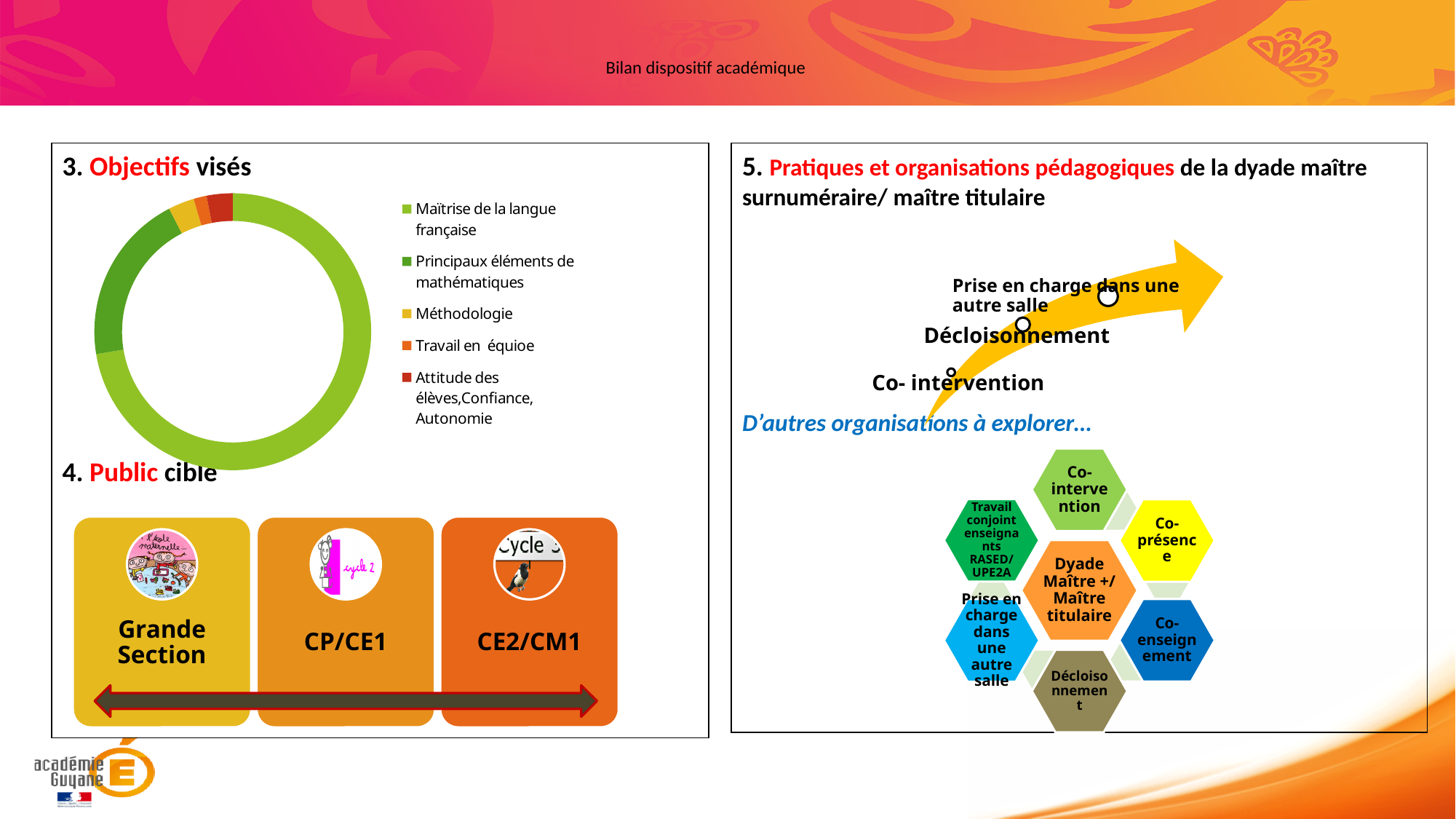
In the doughnut chart under "3. Objectifs visés", which is larger: Maîtrise de la langue française or Principaux éléments de mathématiques? Maîtrise de la langue française Which category takes up the largest share of the doughnut chart under "3. Objectifs visés"? Maîtrise de la langue française In the doughnut chart under "3. Objectifs visés", which is larger: Principaux éléments de mathématiques or Méthodologie? Principaux éléments de mathématiques What kind of chart is shown under "3. Objectifs visés"? Doughnut chart What colour represents Méthodologie in the doughnut chart under "3. Objectifs visés"? Yellow What is the last legend entry of the doughnut chart under "3. Objectifs visés"? Attitude des élèves,Confiance, Autonomie In the doughnut chart under "3. Objectifs visés", which is larger: Maîtrise de la langue française or Attitude des élèves,Confiance, Autonomie? Maîtrise de la langue française How many categories does the legend of the doughnut chart under "3. Objectifs visés" list? 5